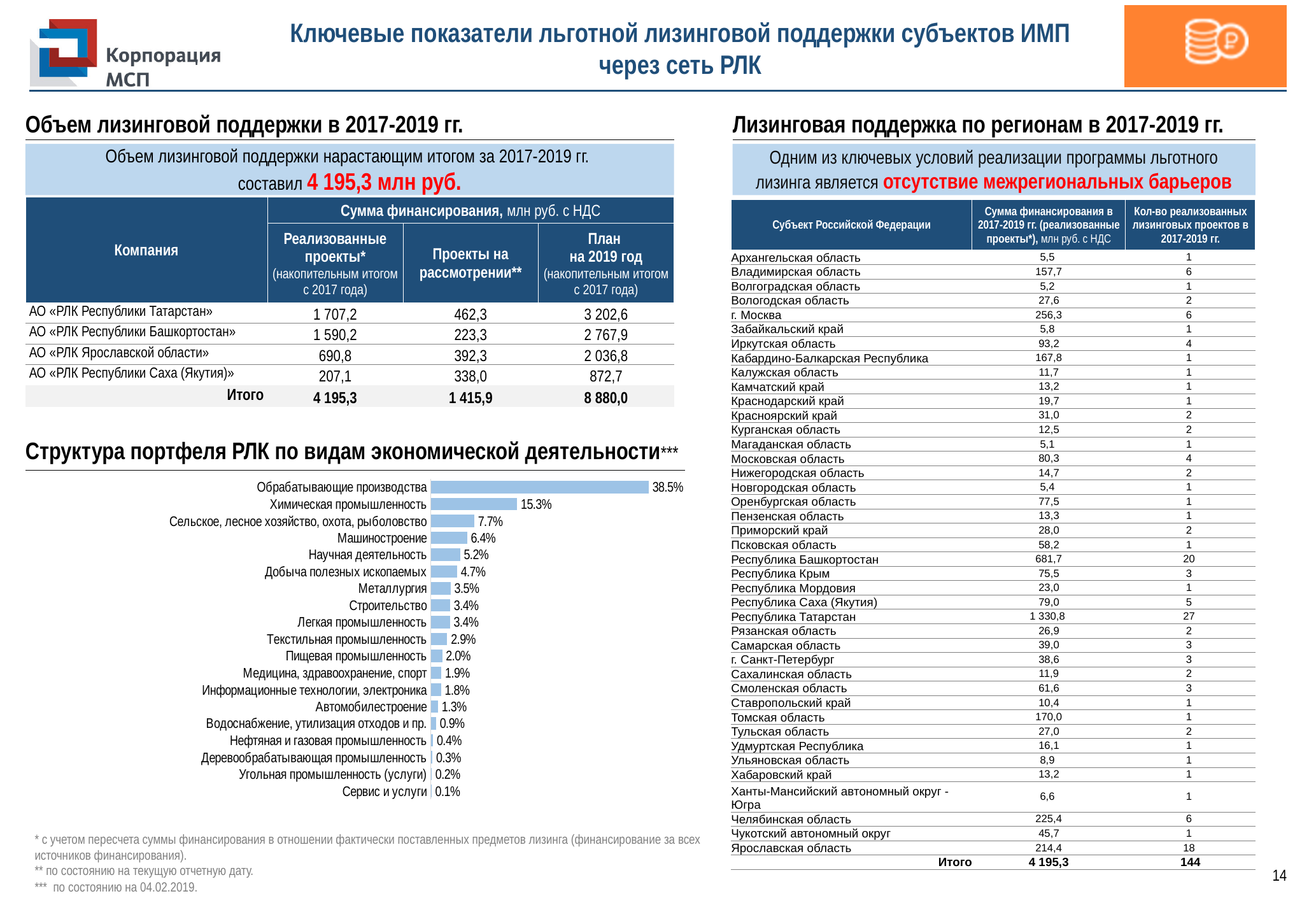
In the bar chart of the RLK portfolio structure, what is the difference between "Обрабатывающие производства" and "Химическая промышленность"? 23.2% In the bar chart of the RLK portfolio structure, what is the value for "Автомобилестроение"? 1.3% In the bar chart of the RLK portfolio structure, what is the value for "Текстильная промышленность"? 2.9% In the bar chart of the RLK portfolio structure, what is the difference between "Сельское, лесное хозяйство, охота, рыболовство" and "Металлургия"? 4.2% In the bar chart of the RLK portfolio structure, which is larger: "Научная деятельность" or "Добыча полезных ископаемых"? Научная деятельность What type of chart is shown under the heading "Структура портфеля РЛК по видам экономической деятельности"? bar chart In the bar chart of the RLK portfolio structure, what is the value for "Химическая промышленность"? 15.3% In the bar chart of the RLK portfolio structure, which category has the highest value? Обрабатывающие производства In the bar chart of the RLK portfolio structure, which category has the lowest value? Сервис и услуги In the bar chart of the RLK portfolio structure, what is the value for "Обрабатывающие производства"? 38.5% In the bar chart of the RLK portfolio structure, what is the value for "Машиностроение"? 6.4% How many categories are shown in the bar chart of the RLK portfolio structure? 19